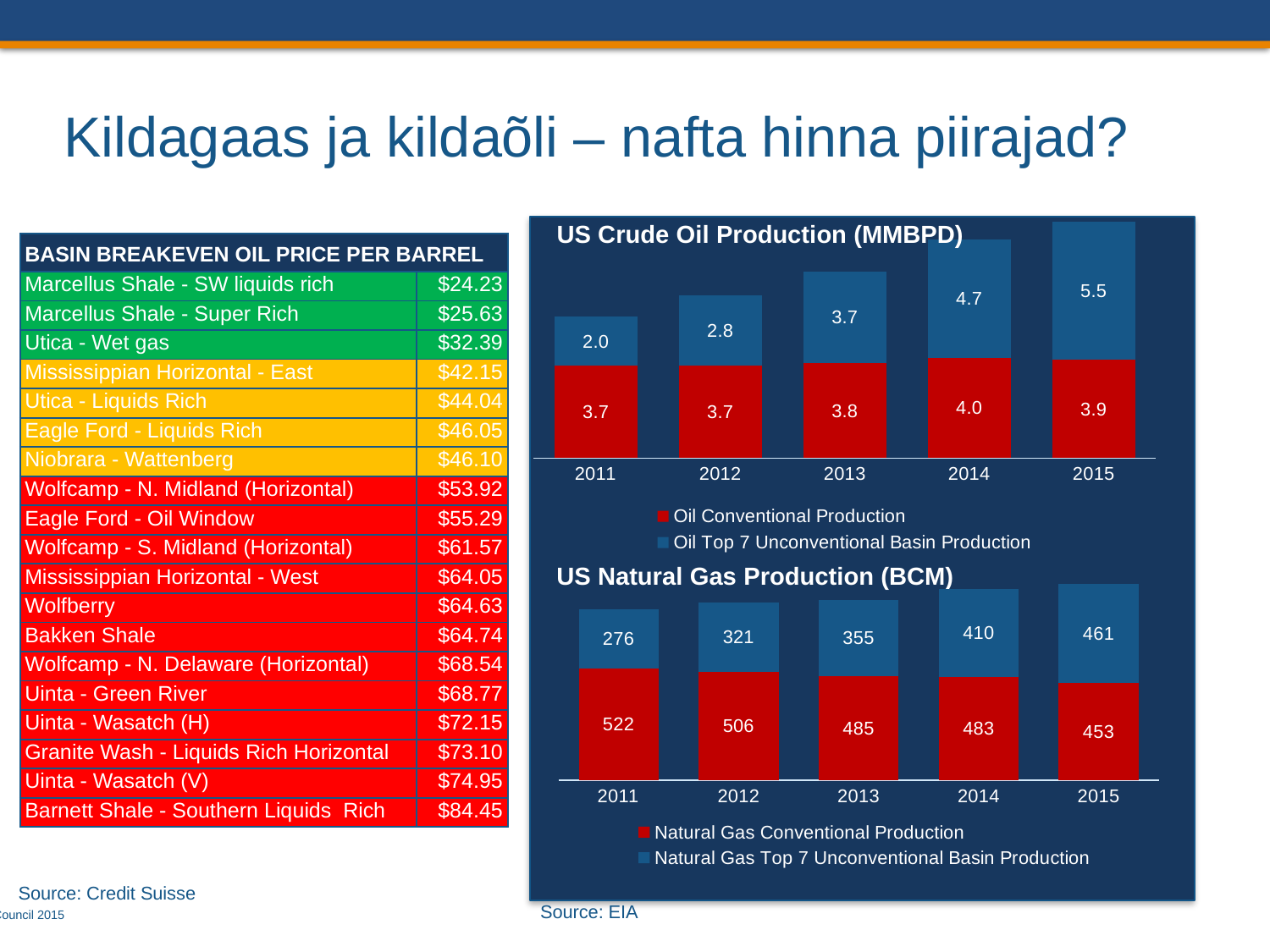
How many years are shown on the x axis of the US Natural Gas Production (BCM) chart? 5 In the US Natural Gas Production (BCM) chart, what is the total production for 2011 (both series combined)? 798 How many series does the legend of the US Crude Oil Production (MMBPD) chart list? 2 In the US Crude Oil Production (MMBPD) chart, which year has the highest Oil Top 7 Unconventional Basin Production? 2015 In the US Crude Oil Production (MMBPD) chart, does Oil Top 7 Unconventional Basin Production rise or fall from 2011 to 2015? rise In the US Crude Oil Production (MMBPD) chart, what is the total production for 2015 (both series combined)? 9.4 In the US Natural Gas Production (BCM) chart, what is the difference between Natural Gas Top 7 Unconventional Basin Production in 2015 and 2011? 185 In the US Crude Oil Production (MMBPD) chart, what is the Oil Top 7 Unconventional Basin Production value for 2015? 5.5 In the US Crude Oil Production (MMBPD) chart, what is the Oil Conventional Production value for 2014? 4.0 In the US Natural Gas Production (BCM) chart, which year has the lowest Natural Gas Conventional Production? 2015 In the US Natural Gas Production (BCM) chart, what is the Natural Gas Conventional Production value for 2013? 485 In the US Natural Gas Production (BCM) chart, which is larger in 2015: Natural Gas Conventional Production or Natural Gas Top 7 Unconventional Basin Production? Natural Gas Top 7 Unconventional Basin Production